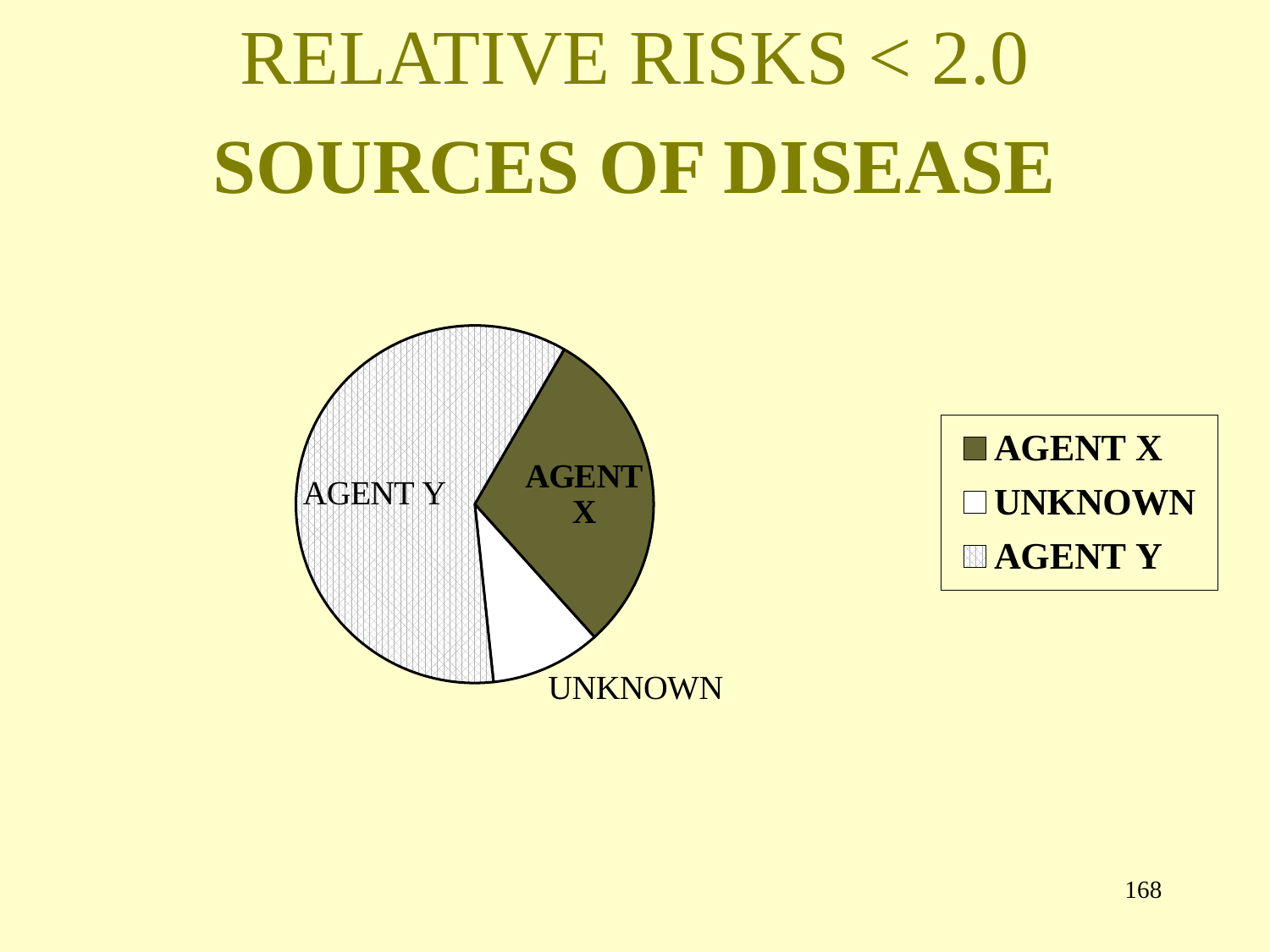
How many entries does the legend list? 3 What are the three categories listed in the legend? AGENT X, UNKNOWN, AGENT Y Which slice of the pie chart is the largest? AGENT Y Which slice is larger, AGENT X or UNKNOWN? AGENT X What kind of chart is shown on the slide? Pie chart Which slice of the pie chart is shown in solid dark olive green? AGENT X Which slice is larger, AGENT Y or AGENT X? AGENT Y Which slice of the pie chart is the smallest? UNKNOWN How many slices does the pie chart have? 3 Which slice is smaller, AGENT Y or UNKNOWN? UNKNOWN